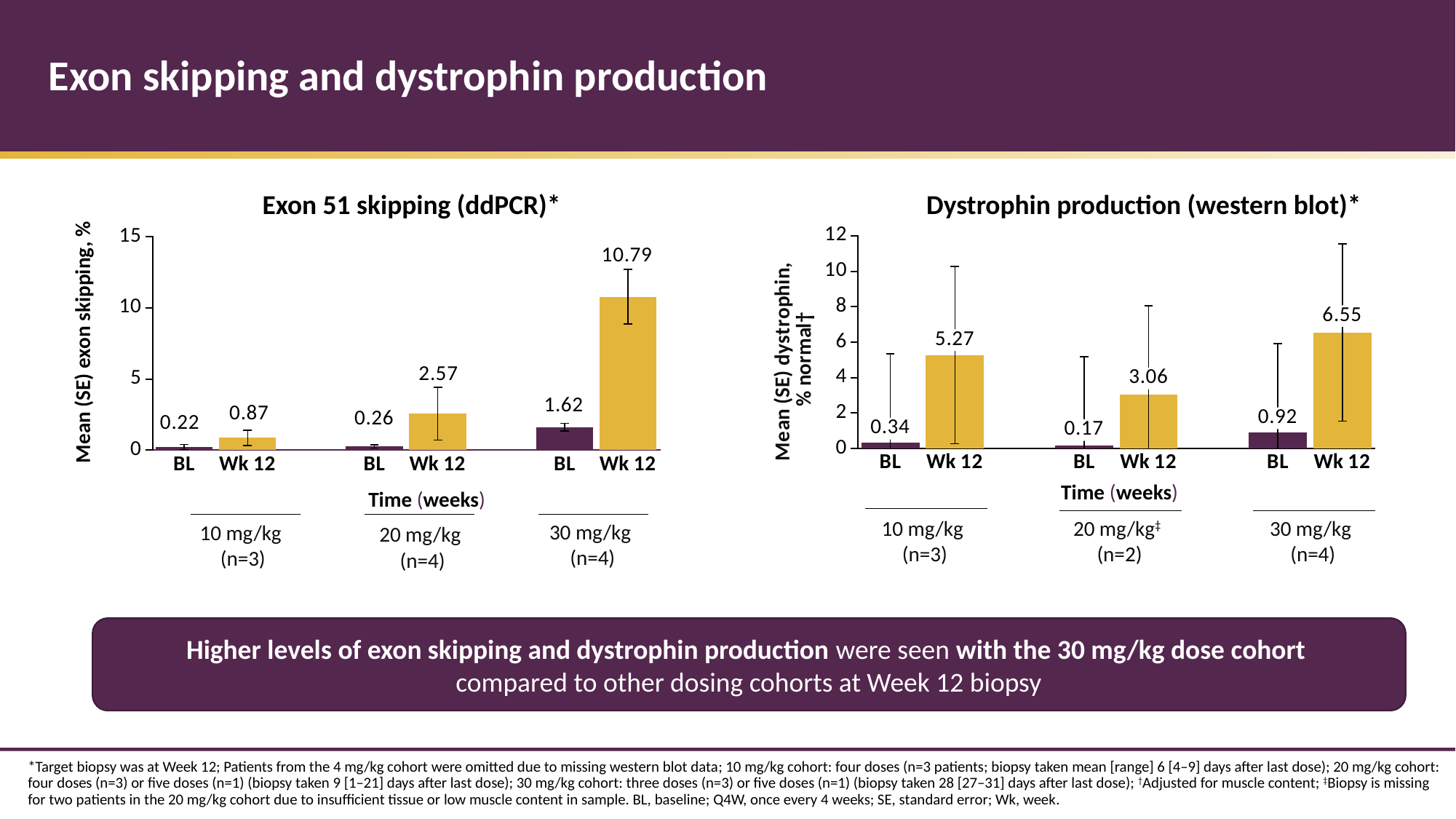
In the Exon 51 skipping (ddPCR) chart, which cohort has the highest Wk 12 value? 30 mg/kg In the Dystrophin production (western blot) chart, what is the difference between the Wk 12 values for the 30 mg/kg and 20 mg/kg cohorts? 3.49 In the Dystrophin production (western blot) chart, what is the Wk 12 value for the 10 mg/kg cohort? 5.27 What type of chart is the Dystrophin production (western blot) chart? bar chart In the Dystrophin production (western blot) chart, what is the BL value for the 30 mg/kg cohort? 0.92 In the Dystrophin production (western blot) chart, which cohort has the lowest BL value? 20 mg/kg In the Exon 51 skipping (ddPCR) chart, what is the BL value for the 20 mg/kg cohort? 0.26 In the Exon 51 skipping (ddPCR) chart, what is the difference between the Wk 12 and BL values for the 30 mg/kg cohort? 9.17 In the Exon 51 skipping (ddPCR) chart, is the Wk 12 value for the 30 mg/kg cohort greater or less than 10? greater In the Exon 51 skipping (ddPCR) chart, how many bars are plotted? 6 In the Dystrophin production (western blot) chart, which is larger: the Wk 12 value for 10 mg/kg or the Wk 12 value for 20 mg/kg? 10 mg/kg In the Exon 51 skipping (ddPCR) chart, what is the Wk 12 value for the 30 mg/kg cohort? 10.79